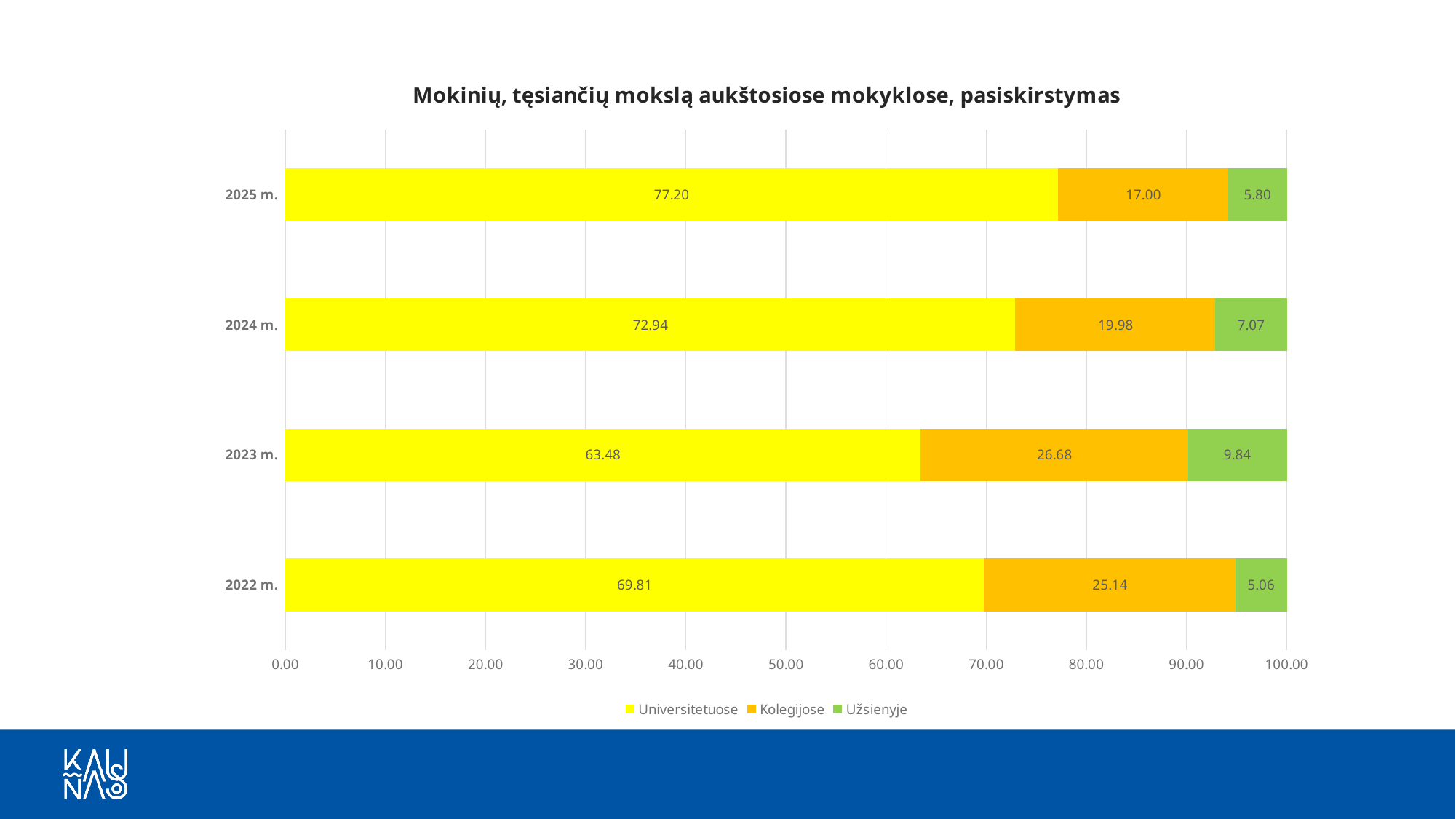
In which year is the Universitetuose value highest? 2025 m. How many years (categories) are shown on the chart? 4 What is the difference between the Universitetuose values for 2025 m. and 2024 m.? 4.26 Which is larger, the Kolegijose value for 2022 m. or for 2023 m.? 2023 m. What is the value for Kolegijose in 2023 m.? 26.68 In which year is the Universitetuose value lowest? 2023 m. What is the value for Užsienyje in 2022 m.? 5.06 From 2023 m. to 2025 m., does the Kolegijose value rise or fall? fall In which year is the Užsienyje value highest? 2023 m. What type of chart is shown on the slide? Stacked bar chart How many series does the legend list? 3 What is the value for Universitetuose in 2025 m.? 77.20